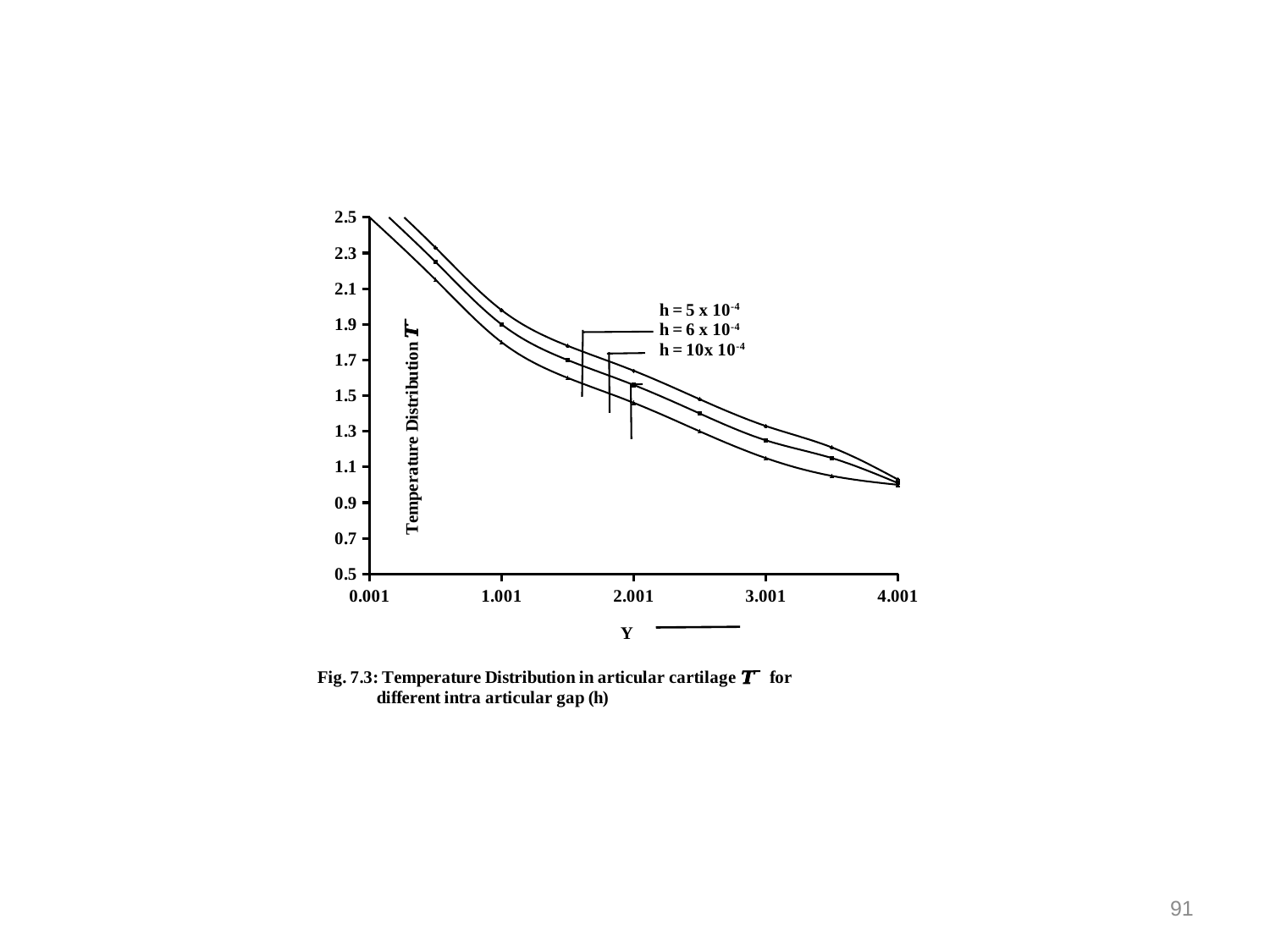
What kind of chart is shown on the slide? line chart At Y = 2.001, is the highest curve greater or less than 1.9? less At Y = 4.001, are the curves greater or less than 1.3? less What is the label of the y axis? Temperature Distribution T Do the temperature distribution curves rise or fall as Y increases from 0.001 to 4.001? fall What is the figure number given in the caption below the chart? Fig. 7.3 How many series does the legend list? 3 At Y = 0.001, is the value of the curves greater or less than 2.1? greater How many tick labels are shown on the x axis (Y)? 5